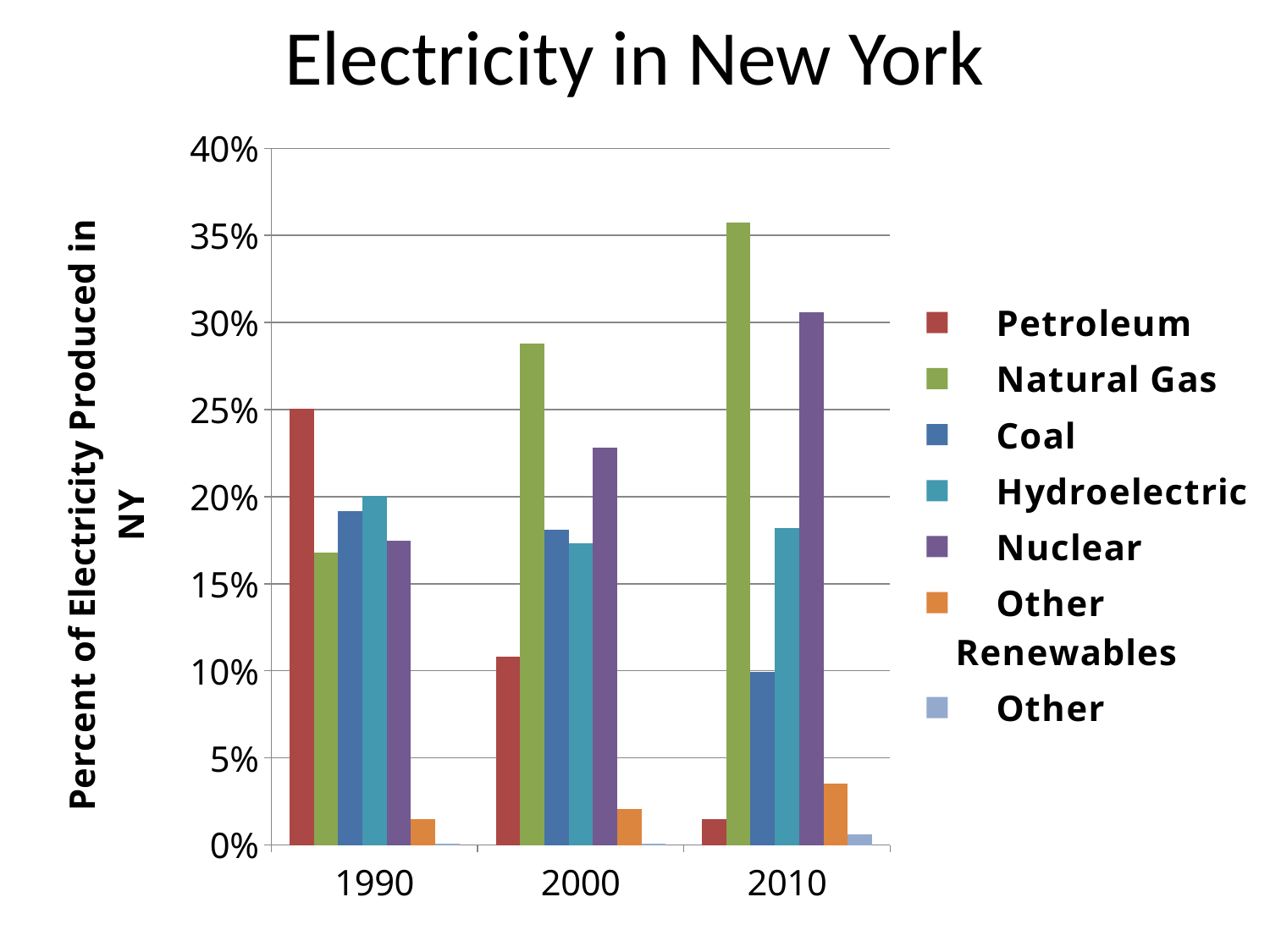
Is the value for Coal in 2010 greater or less than 15%? less Which energy source has the highest value in 2010? Natural Gas What kind of chart is shown on the slide? bar chart Which energy source has the lowest value in 2010? Other Does the Petroleum value rise or fall from 1990 to 2010? fall Which energy source has the highest value in 1990? Petroleum How many years are shown on the x axis? 3 In 2000, which is larger: Natural Gas or Nuclear? Natural Gas Is the value for Nuclear in 2010 greater or less than 25%? greater What is the title of the chart? Electricity in New York How many series does the legend list? 7 Does the Natural Gas value rise or fall from 1990 to 2010? rise